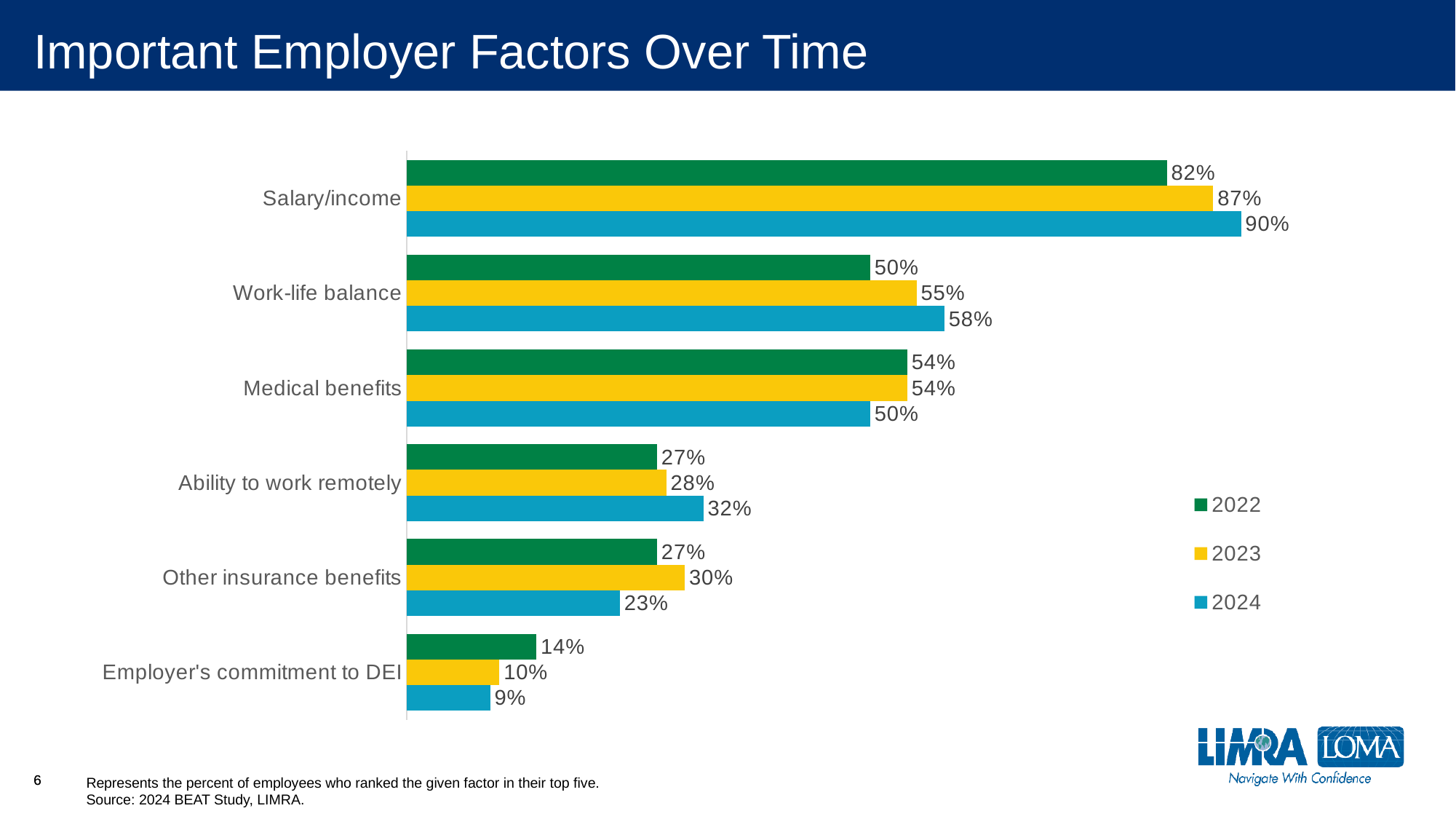
What is the 2024 value for Salary/income? 90% Which factor has the highest 2024 value? Salary/income Which colour represents 2023 in the legend? Yellow Did the value for Employer's commitment to DEI rise or fall from 2022 to 2024? Fall What is the 2023 value for Other insurance benefits? 30% What is the 2022 value for Work-life balance? 50% What kind of chart is shown on the slide? Bar chart Which factor has the lowest 2022 value? Employer's commitment to DEI What is the difference between the 2024 and 2022 values for Salary/income? 8% How many factors (categories) are shown on the chart? 6 Which is larger for Medical benefits: the 2023 value or the 2024 value? 2023 How many series does the legend list? 3